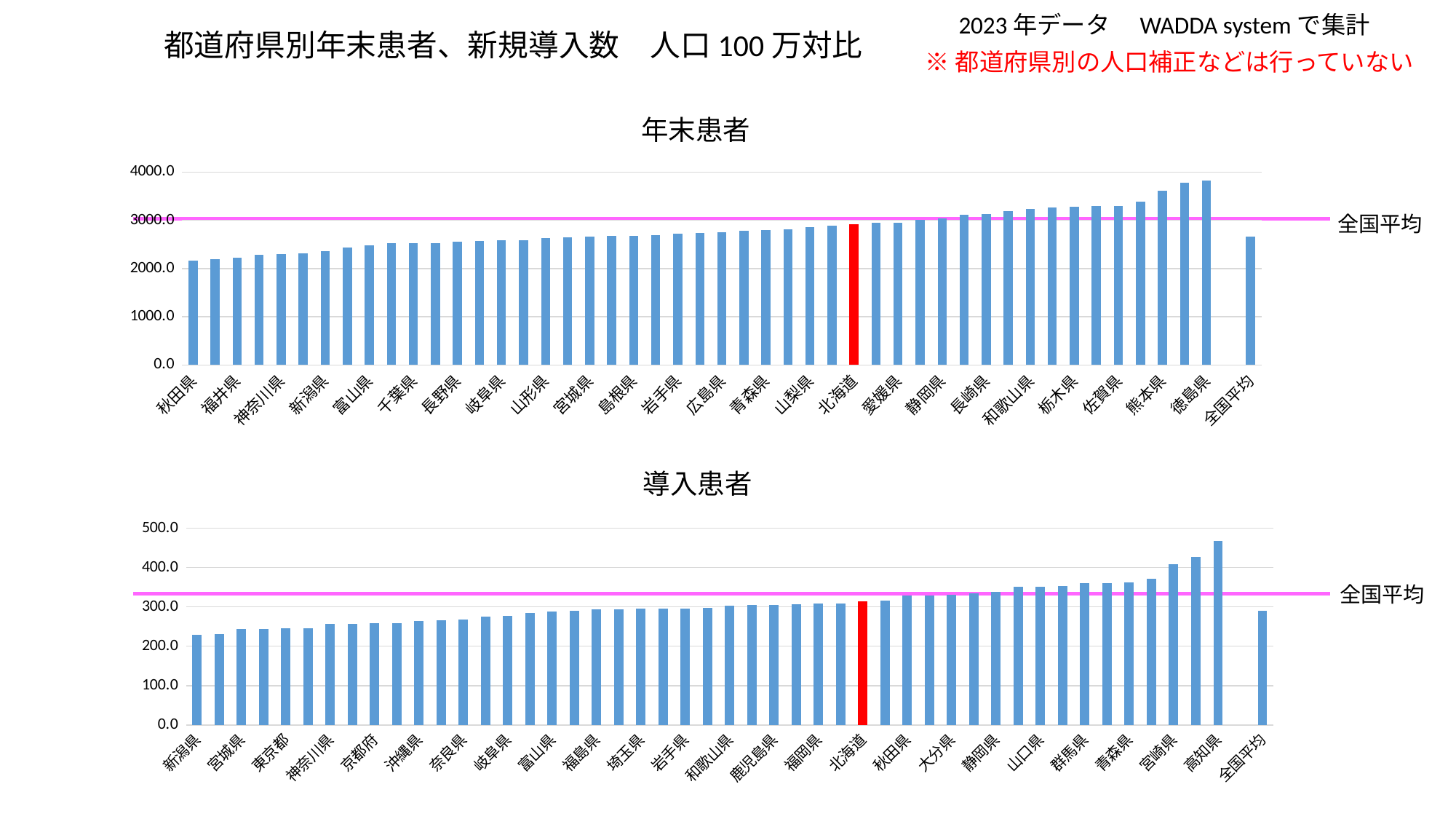
In the top chart (年末患者), which is larger, the value for 秋田県 or the value for 徳島県? 徳島県 In the top chart (年末患者), which prefecture's bar is drawn in red? 北海道 In the bottom chart (導入患者), is the value for 高知県 greater or less than 400? greater In the bottom chart (導入患者), is the value for 新潟県 greater or less than 300? less In the top chart (年末患者), do the prefecture bars rise or fall from left to right? rise In the bottom chart (導入患者), do the prefecture bars rise or fall from left to right? rise In the top chart (年末患者), is the value for 秋田県 greater or less than 3000? less In the bottom chart (導入患者), which is larger, the value for 新潟県 or the value for 高知県? 高知県 What kind of chart is the top chart titled 年末患者? bar chart In the bottom chart (導入患者), which prefecture's bar is drawn in red? 北海道